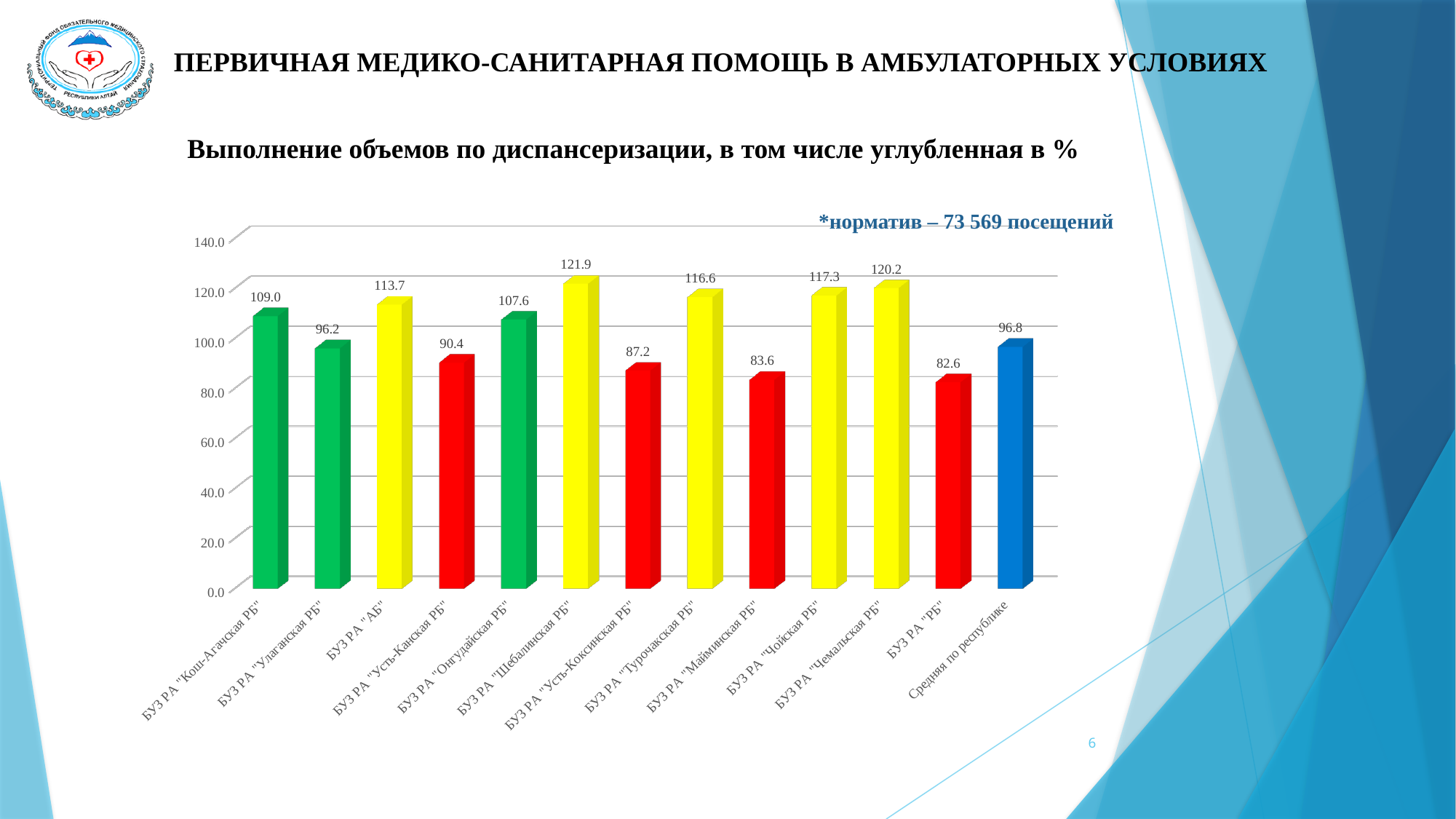
How many categories are shown on the x axis? 13 What is the difference between the values for БУЗ РА "АБ" and БУЗ РА "Улаганская РБ"? 17.5 Is the value for БУЗ РА "Турочакская РБ" greater or less than 100.0? greater What is the value for Средняя по республике? 96.8 What is the value for БУЗ РА "Усть-Канская РБ"? 90.4 Which category has the lowest value? БУЗ РА "РБ" What is the value for БУЗ РА "Шебалинская РБ"? 121.9 Which is larger, the value for БУЗ РА "Кош-Агачская РБ" or the value for БУЗ РА "Онгудайская РБ"? БУЗ РА "Кош-Агачская РБ" Which category has the highest value? БУЗ РА "Шебалинская РБ" What type of chart is shown on the slide? bar chart What is the difference between the values for БУЗ РА "Чемальская РБ" and БУЗ РА "Майминская РБ"? 36.6 What norm (норматив) is stated above the chart? 73 569 посещений